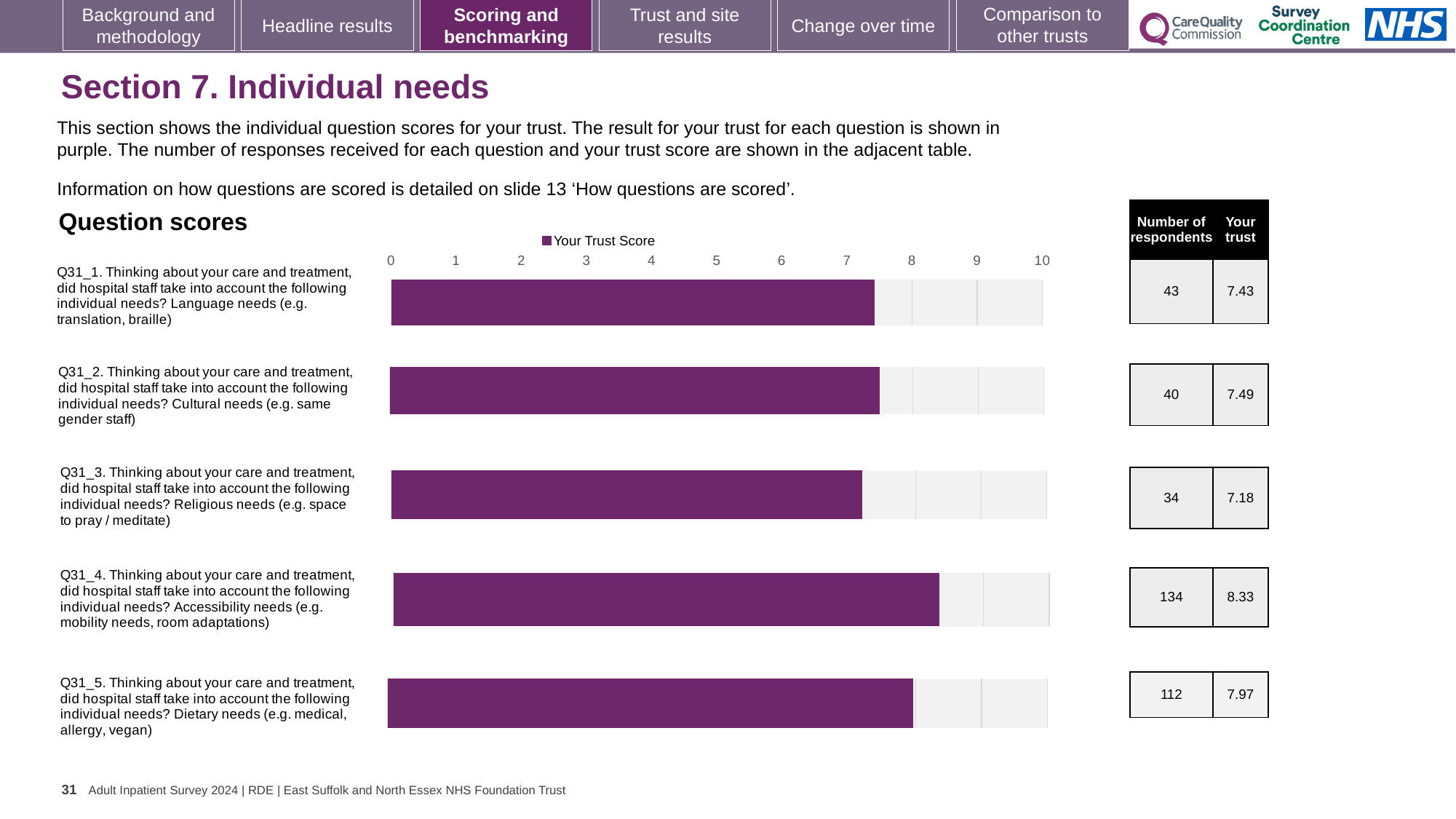
What is the trust score for Q31_4 (Accessibility needs)? 8.33 Which question has the highest trust score? Q31_4 (Accessibility needs) Is the trust score for Q31_4 greater or less than 8? greater What is the trust score for Q31_1 (Language needs)? 7.43 Which question has the lowest trust score? Q31_3 (Religious needs) How many series does the chart legend list? 1 What is the trust score for Q31_5 (Dietary needs)? 7.97 How many questions are plotted in the chart? 5 Is the trust score for Q31_3 greater or less than 8? less Which has the larger trust score, Q31_5 (Dietary needs) or Q31_2 (Cultural needs)? Q31_5 (Dietary needs) What is the difference between the trust scores for Q31_4 and Q31_3? 1.15 What kind of chart is shown on the slide? Bar chart